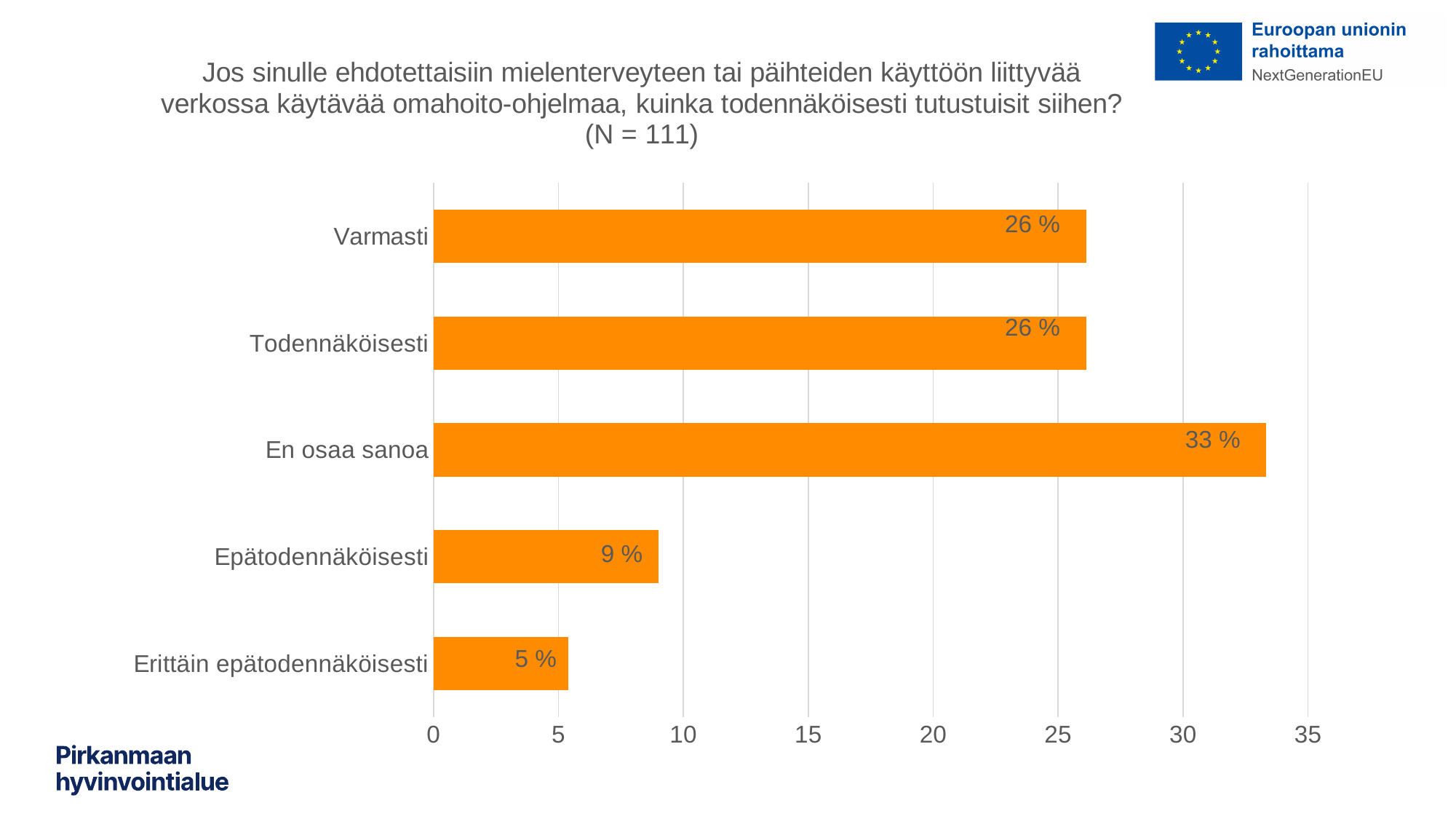
What kind of chart is shown on the slide? bar chart Is the value for En osaa sanoa greater or less than 30? greater Which category has the lowest value? Erittäin epätodennäköisesti What is the value for Erittäin epätodennäköisesti? 5 % What is the value for Epätodennäköisesti? 9 % Which is larger, the value for Todennäköisesti or the value for Epätodennäköisesti? Todennäköisesti Which category has the highest value? En osaa sanoa What is the value for En osaa sanoa? 33 % What is the N value stated in the chart title? 111 What is the difference between the values for En osaa sanoa and Epätodennäköisesti? 24 % What is the value for Varmasti? 26 % How many categories are shown in the chart? 5